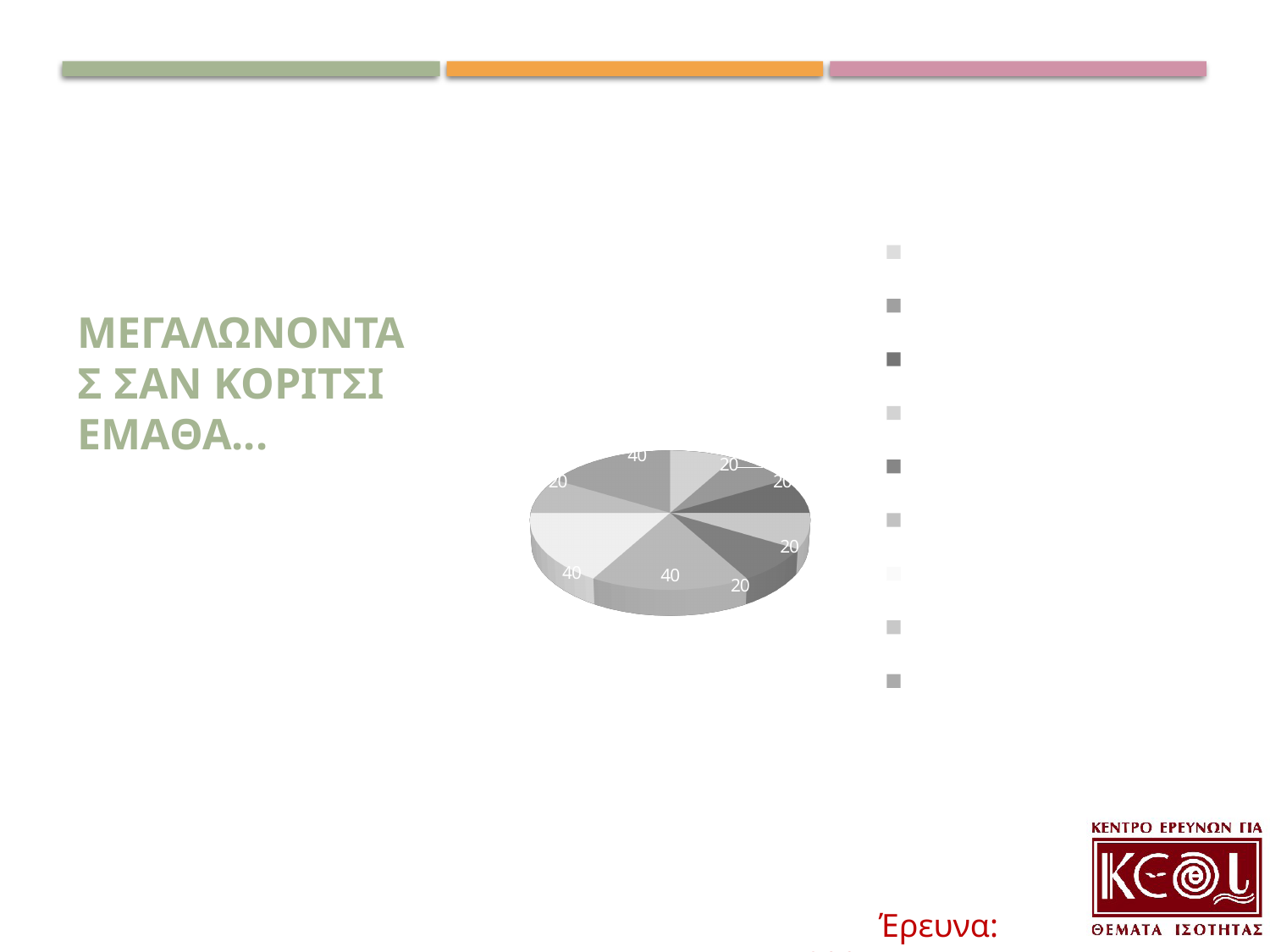
What is the smallest data label value shown on the pie chart? 20 What is the largest data label value shown on the pie chart? 40 Is the pie chart drawn in 3D or flat 2D? 3D How many slices of the pie chart are labelled 40? 3 What kind of chart is shown on the slide? pie chart What is the difference between a slice labelled 40 and a slice labelled 20 on the pie chart? 20